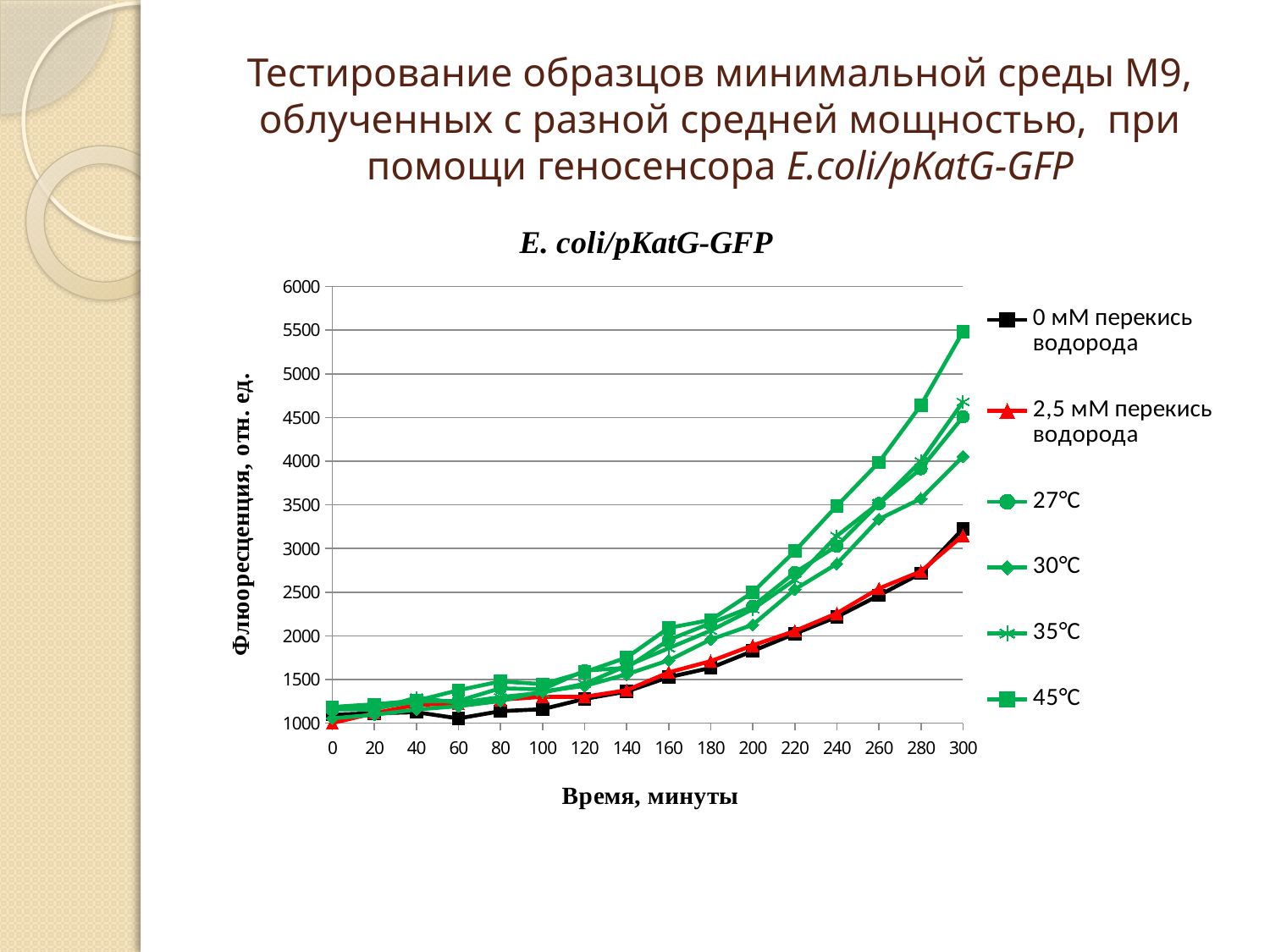
Is the value for 0 мМ перекись водорода at 300 minutes greater or less than 3000? greater At 300 minutes, which is larger: the value for 45°C or the value for 30°C? 45°C What is the title of the x axis? Время, минуты Is the value for 45°C at 200 minutes greater or less than 2000? greater How many series does the legend list? 6 How many time points are plotted along the x axis for each series? 16 Is the value for 45°C at 300 minutes greater or less than 5000? greater What kind of chart is shown on the slide? line chart Do the fluorescence values generally rise or fall as time increases from 0 to 300 minutes? rise Which series has the highest value at 300 minutes? 45°C